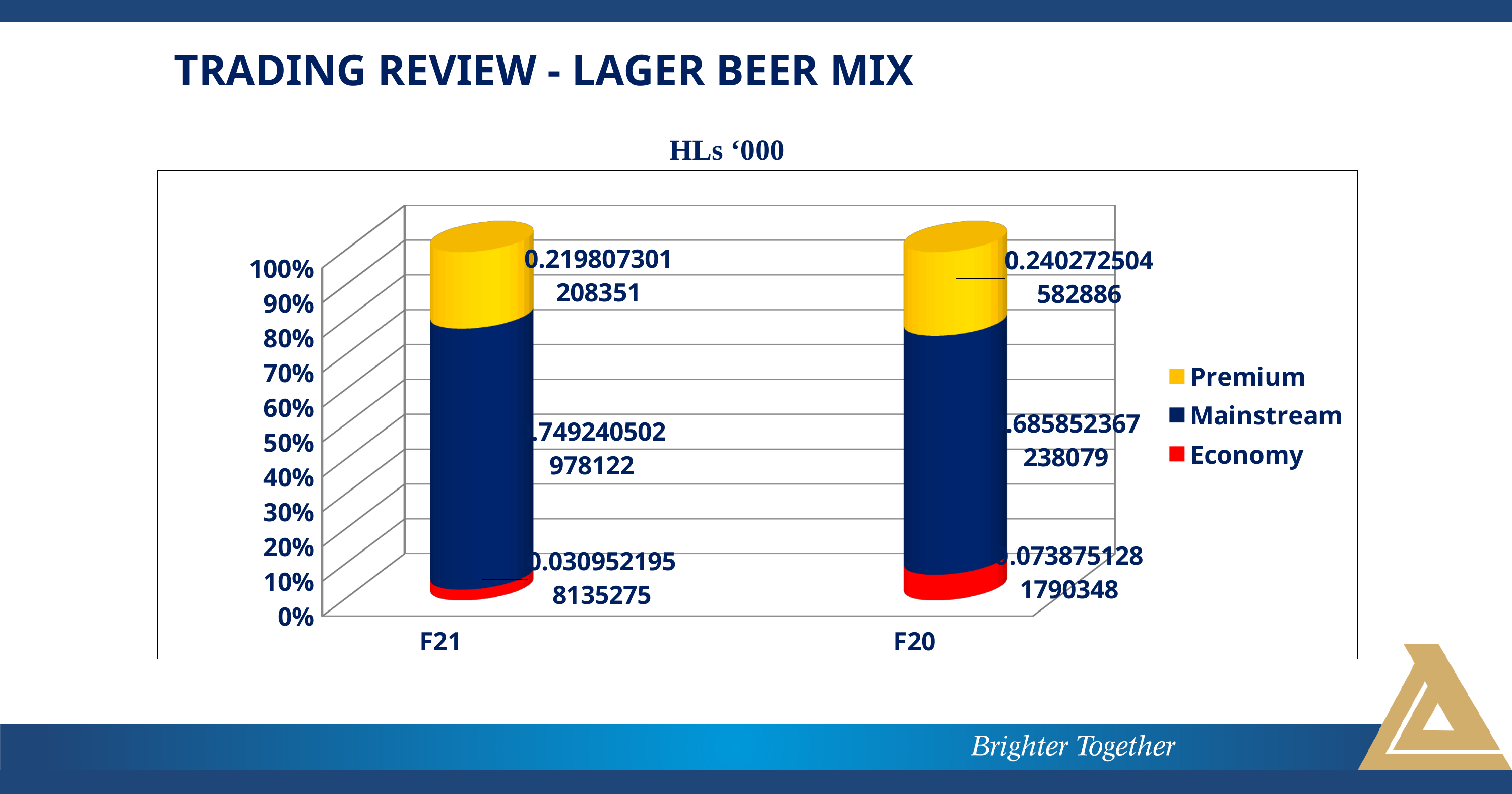
What kind of chart is shown on the slide? Stacked bar chart Which series has the smallest share in F20? Economy What is the data label for Premium in F20? 0.240272504582886 Which series is shown in yellow in the chart? Premium How many series does the chart legend list? 3 What is the data label for Premium in F21? 0.219807301208351 How many categories are shown on the x axis of the chart? 2 Is the Premium share larger in F21 or F20? F20 What is the title shown above the chart? HLs '000 Which series has the largest share in F21? Mainstream Is the Economy share in F21 greater or less than 10%? less Is the Mainstream share larger in F21 or F20? F21